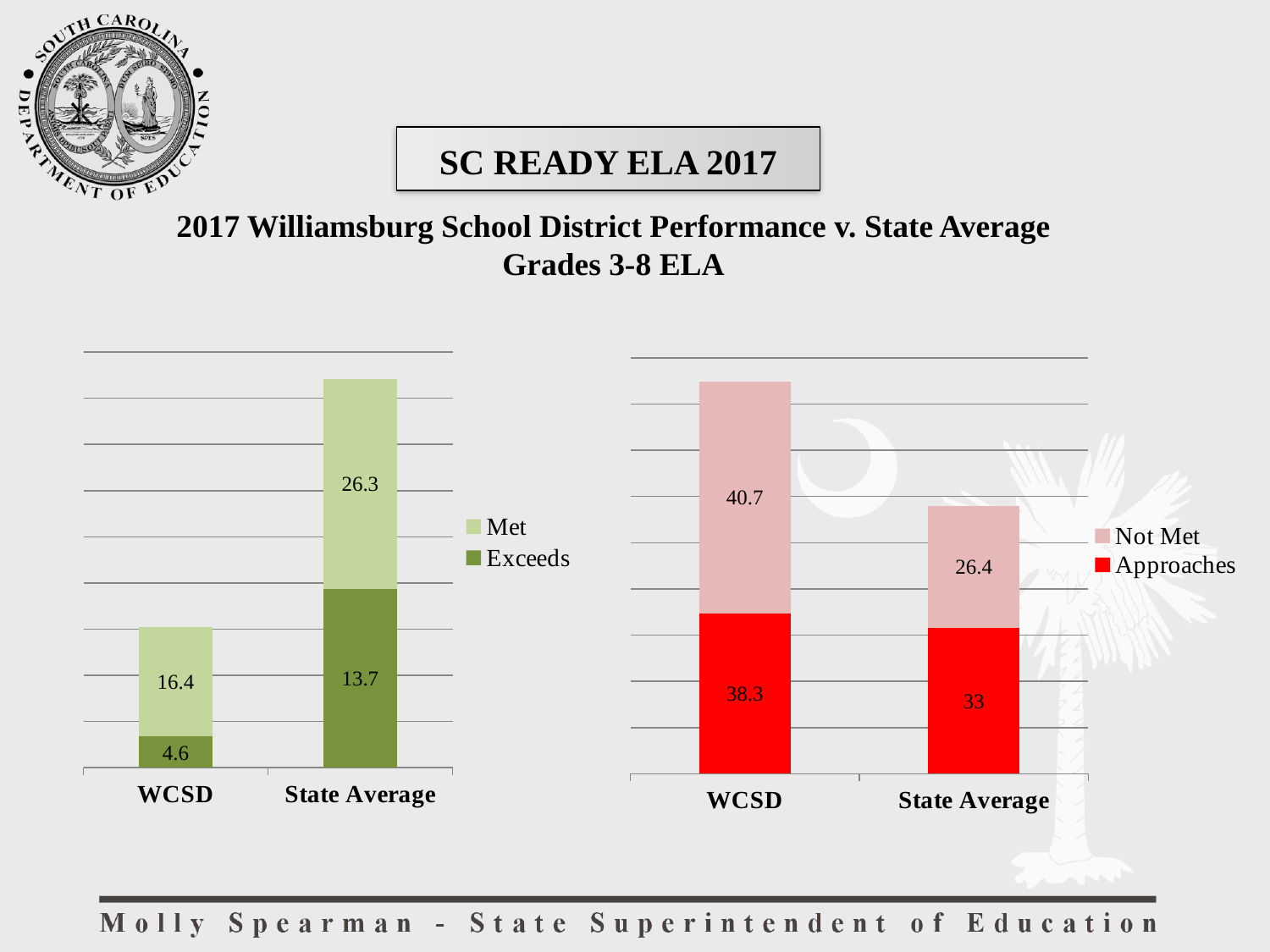
In the right chart, what is the Approaches value for State Average? 33 In the right chart, what is the total of the stacked bar for WCSD? 79 How many series does the legend of the right chart list? 2 In the left chart, what is the total of the stacked bar for State Average? 40 In the left chart, which category has the larger Exceeds value, WCSD or State Average? State Average In the right chart, which category has the larger Approaches value, WCSD or State Average? WCSD In the right chart, what is the difference between the Not Met values for WCSD and State Average? 14.3 In the left chart, what is the difference between the Met values for State Average and WCSD? 9.9 What kind of chart is the left chart? Stacked bar chart In the left chart, what is the Exceeds value for State Average? 13.7 In the right chart, what is the Not Met value for WCSD? 40.7 In the left chart, what is the Met value for WCSD? 16.4